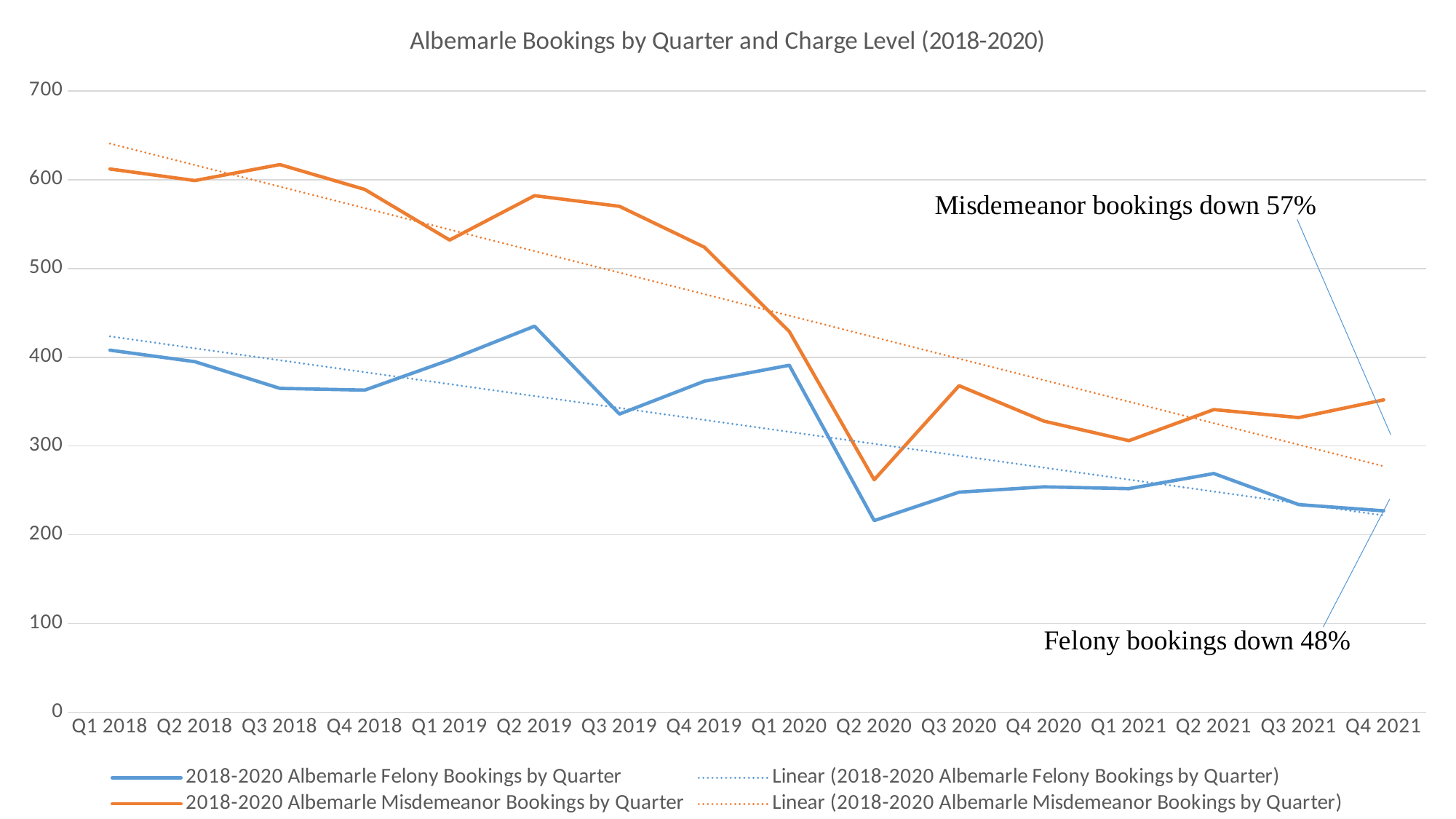
In which quarter do the Albemarle Misdemeanor Bookings reach their lowest value? Q2 2020 What kind of chart is shown on the slide? Line chart In which quarter do the Albemarle Felony Bookings reach their lowest value? Q2 2020 How many quarters are plotted along the x axis? 16 According to the annotation on the chart, by what percentage are felony bookings down? 48% In which quarter do the Albemarle Felony Bookings reach their highest value? Q2 2019 How many series does the legend list? 4 Overall, do the Albemarle Misdemeanor Bookings rise or fall from Q1 2018 to Q4 2021? Fall Is the value for Misdemeanor Bookings in Q2 2020 greater or less than 300? less Is the value for Felony Bookings in Q2 2019 greater or less than 400? greater Is the value for Misdemeanor Bookings in Q4 2019 greater or less than 500? greater In Q1 2018, which is larger: Felony Bookings or Misdemeanor Bookings? Misdemeanor Bookings